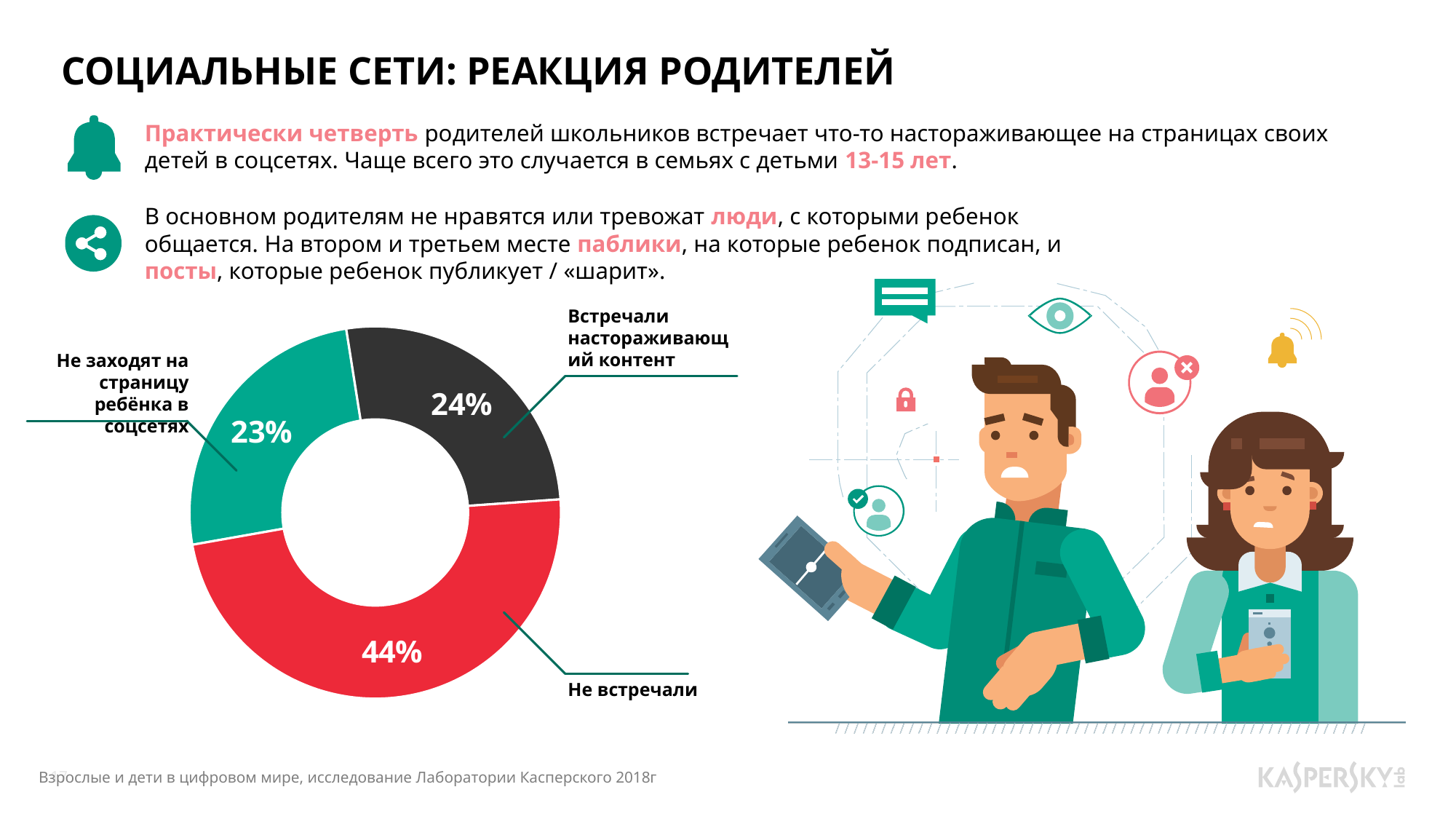
How many slices does the donut chart have? 3 Which category has the largest slice in the donut chart? Не встречали What is the difference between the "Встречали настораживающий контент" share and the "Не заходят на страницу ребёнка в соцсетях" share? 1% What share of parents "Не встречали"? 44% What share of parents "Не заходят на страницу ребёнка в соцсетях"? 23% Which is larger: the share for "Встречали настораживающий контент" or for "Не заходят на страницу ребёнка в соцсетях"? Встречали настораживающий контент What colour is the "Не встречали" slice of the donut chart? Red What share of parents "Встречали настораживающий контент"? 24% What colour is the "Не заходят на страницу ребёнка в соцсетях" slice of the donut chart? Green What kind of chart is shown on the slide? Donut (pie) chart Which category has the smallest slice in the donut chart? Не заходят на страницу ребёнка в соцсетях What is the difference between the "Не встречали" share and the "Встречали настораживающий контент" share? 20%